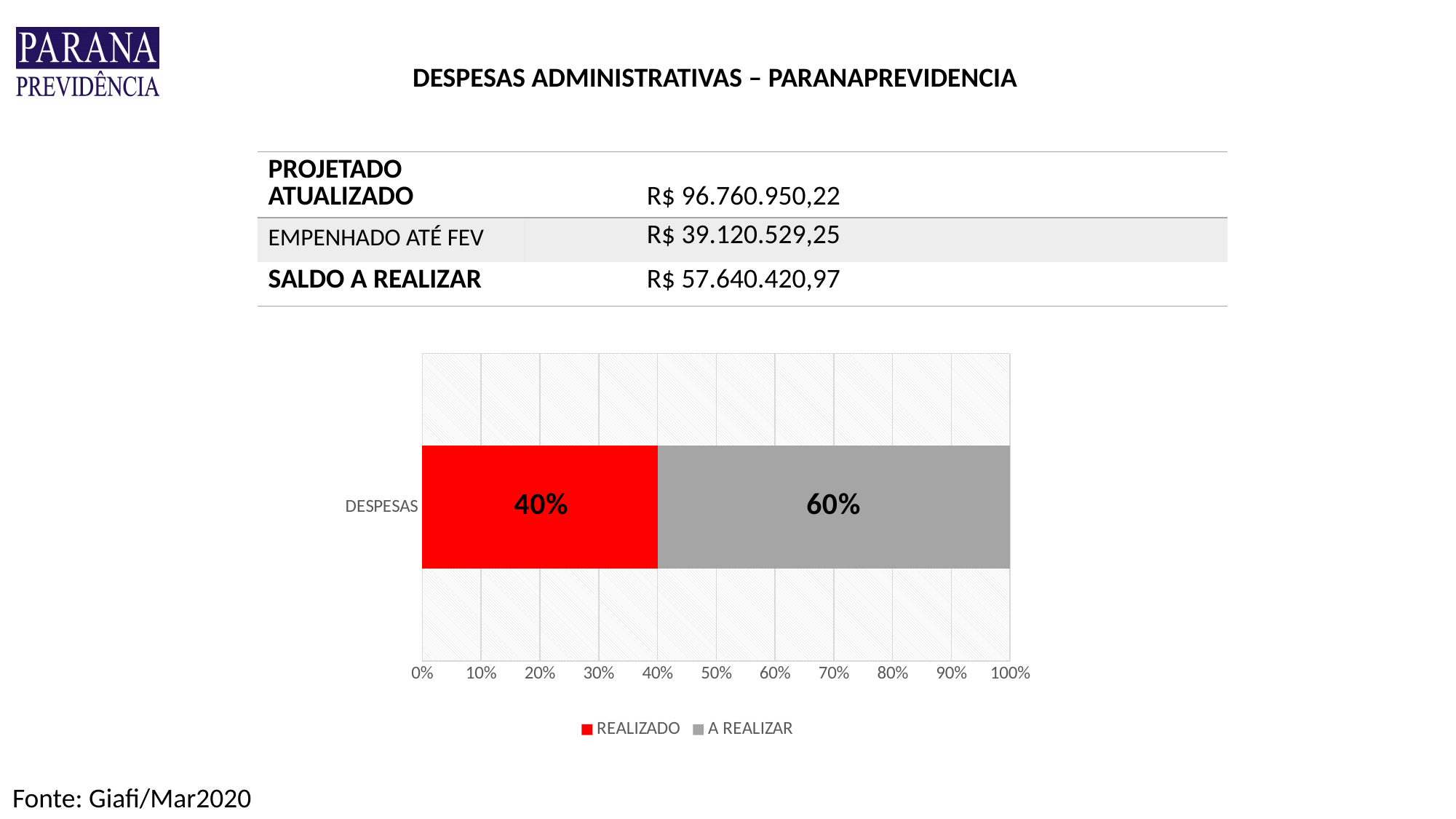
What is the value of the REALIZADO series for DESPESAS? 40% Which series has the larger value for DESPESAS, REALIZADO or A REALIZAR? A REALIZAR What is the total of the stacked bar for DESPESAS? 100% What colour represents the REALIZADO series? Red How many categories are shown on the chart? 1 What is the label of the category on the chart's vertical axis? DESPESAS Is the A REALIZAR value for DESPESAS greater or less than 50%? greater How many series does the legend list? 2 What kind of chart is shown on the slide? Stacked bar chart What is the difference between the A REALIZAR and REALIZADO values for DESPESAS? 20% What is the value of the A REALIZAR series for DESPESAS? 60% Is the REALIZADO value for DESPESAS greater or less than 50%? less